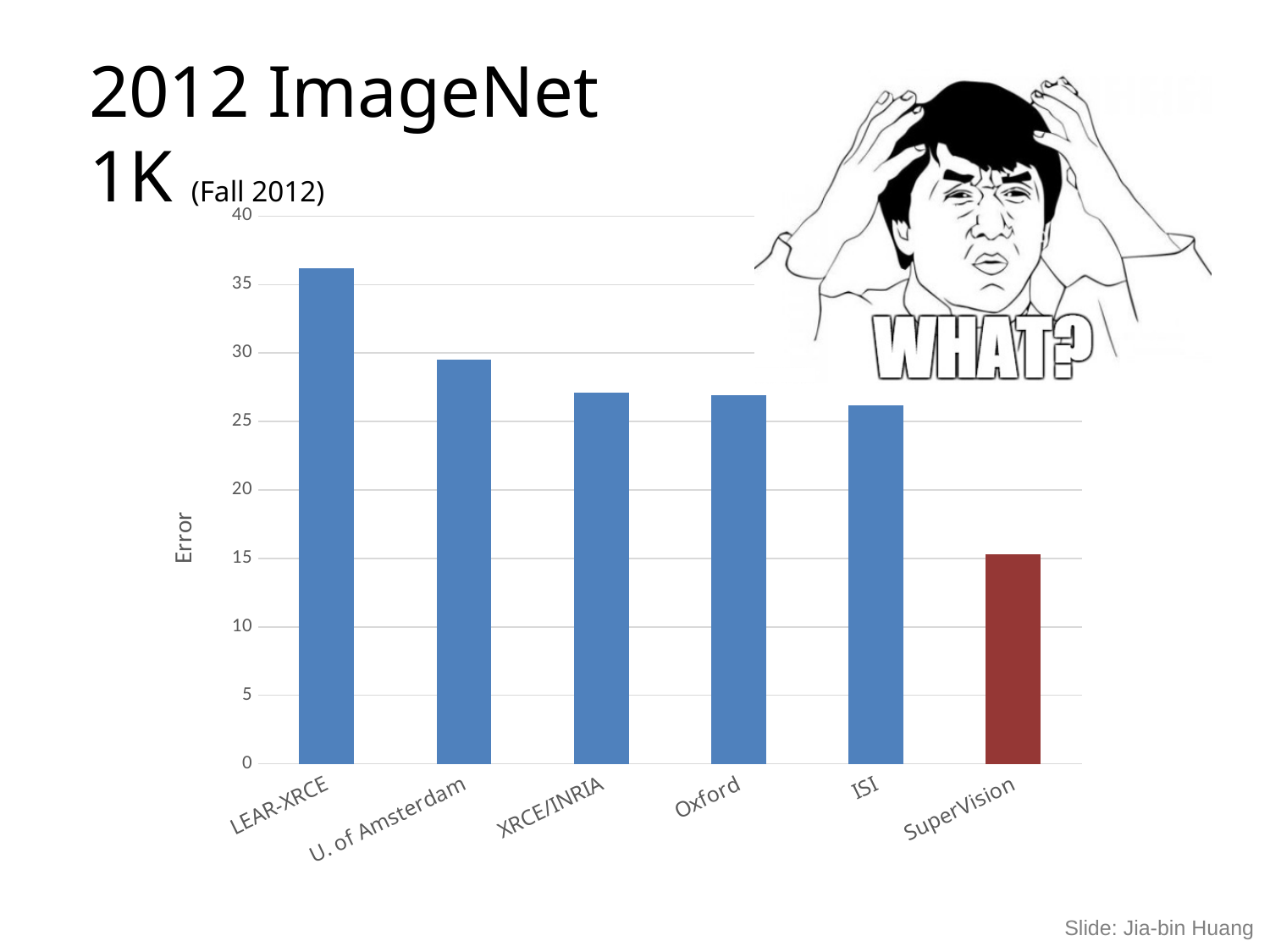
Is the error for Oxford greater or less than 30? less What kind of chart is shown on the slide? bar chart Which bar in the chart is coloured differently (red) from the others? SuperVision Is the error for SuperVision greater or less than 20? less Which team has the lowest error in the chart? SuperVision Which has a larger error, LEAR-XRCE or U. of Amsterdam? LEAR-XRCE Is the error for LEAR-XRCE greater or less than 30? greater Which team has the highest error in the chart? LEAR-XRCE Do the error values rise or fall from left to right along the x axis? fall How many categories (teams) are shown on the x axis of the chart? 6 Which has a larger error, ISI or SuperVision? ISI